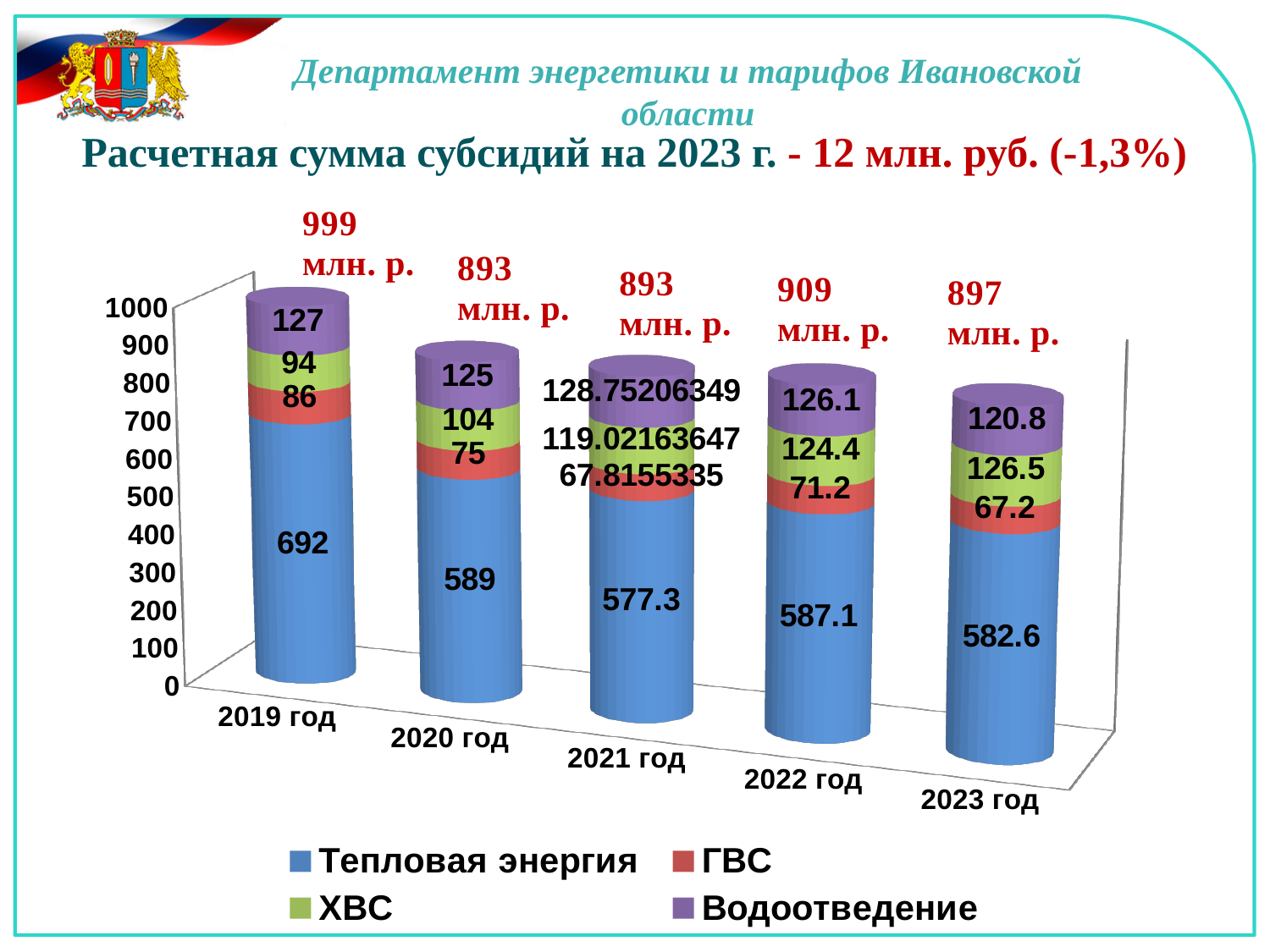
What is the value of Тепловая энергия for 2019 год? 692 How many series does the legend list? 4 Do the ХВС values rise or fall from 2019 год to 2023 год? Rise What kind of chart is shown on the slide? Stacked bar chart What is the value of ГВС for 2022 год? 71.2 Which year has the lowest value for ГВС? 2023 год What is the difference between the Тепловая энергия values for 2019 год and 2020 год? 103 What is the value of Водоотведение for 2023 год? 120.8 What total is printed above the bar for 2022 год? 909 млн. р. Which year has the highest value for Тепловая энергия? 2019 год Which year has the larger ХВС value, 2022 год or 2023 год? 2023 год How many years are shown on the x axis? 5